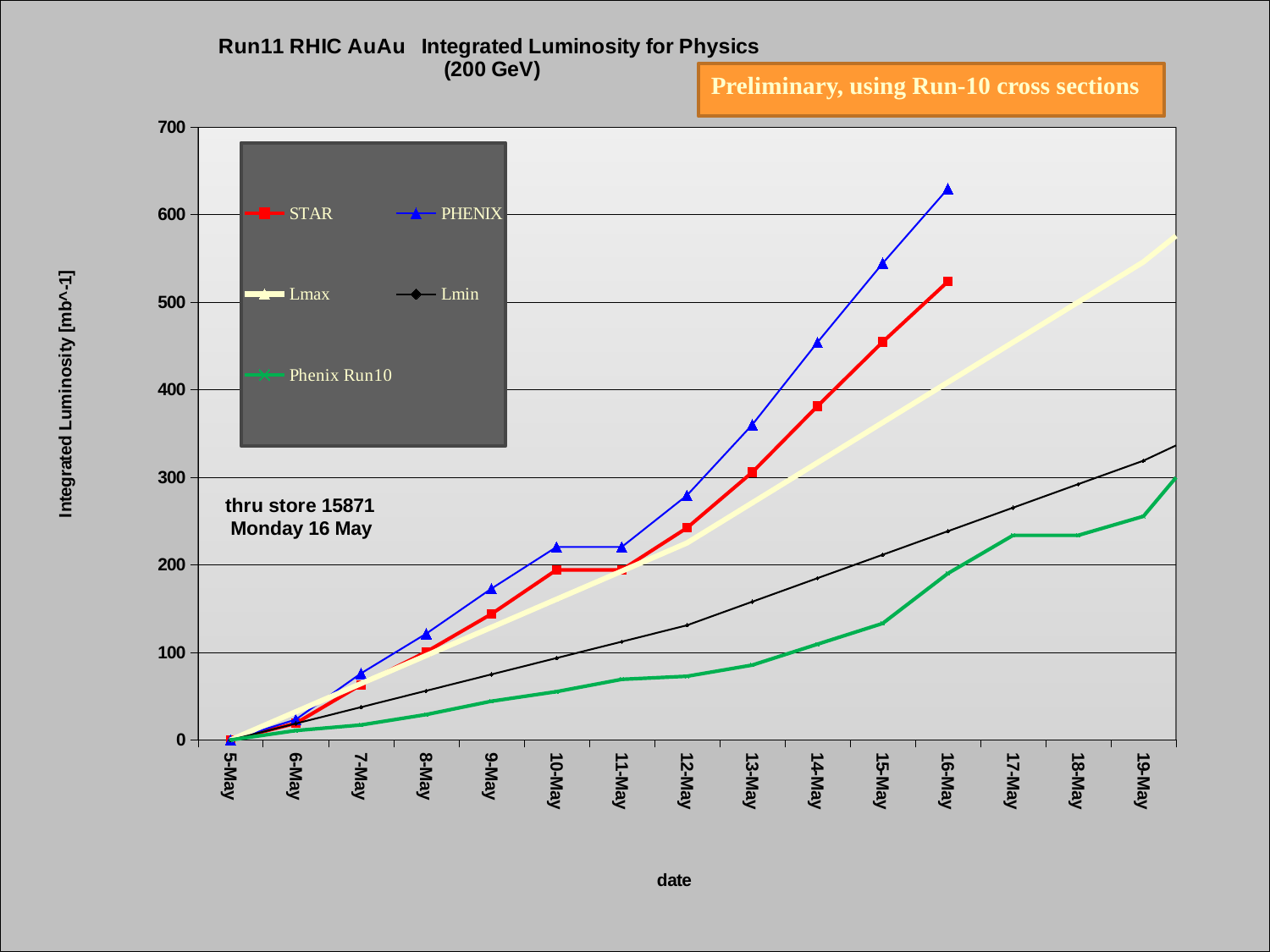
Is the PHENIX value on 16-May greater or less than 600? greater Is the Phenix Run10 value on 19-May greater or less than 400? less Does the STAR series rise or fall from 5-May to 16-May? rise On 16-May, which is higher, PHENIX or STAR? PHENIX How many series does the legend list? 5 How many dates are shown along the x axis? 15 Which series has the lowest value on 16-May? Phenix Run10 Which series has the highest value on 16-May? PHENIX Is the STAR value on 16-May greater or less than 500? greater What is the label of the y axis? Integrated Luminosity [mb^-1] What kind of chart is shown on the slide? line chart On 19-May, which is higher, Lmax or Lmin? Lmax